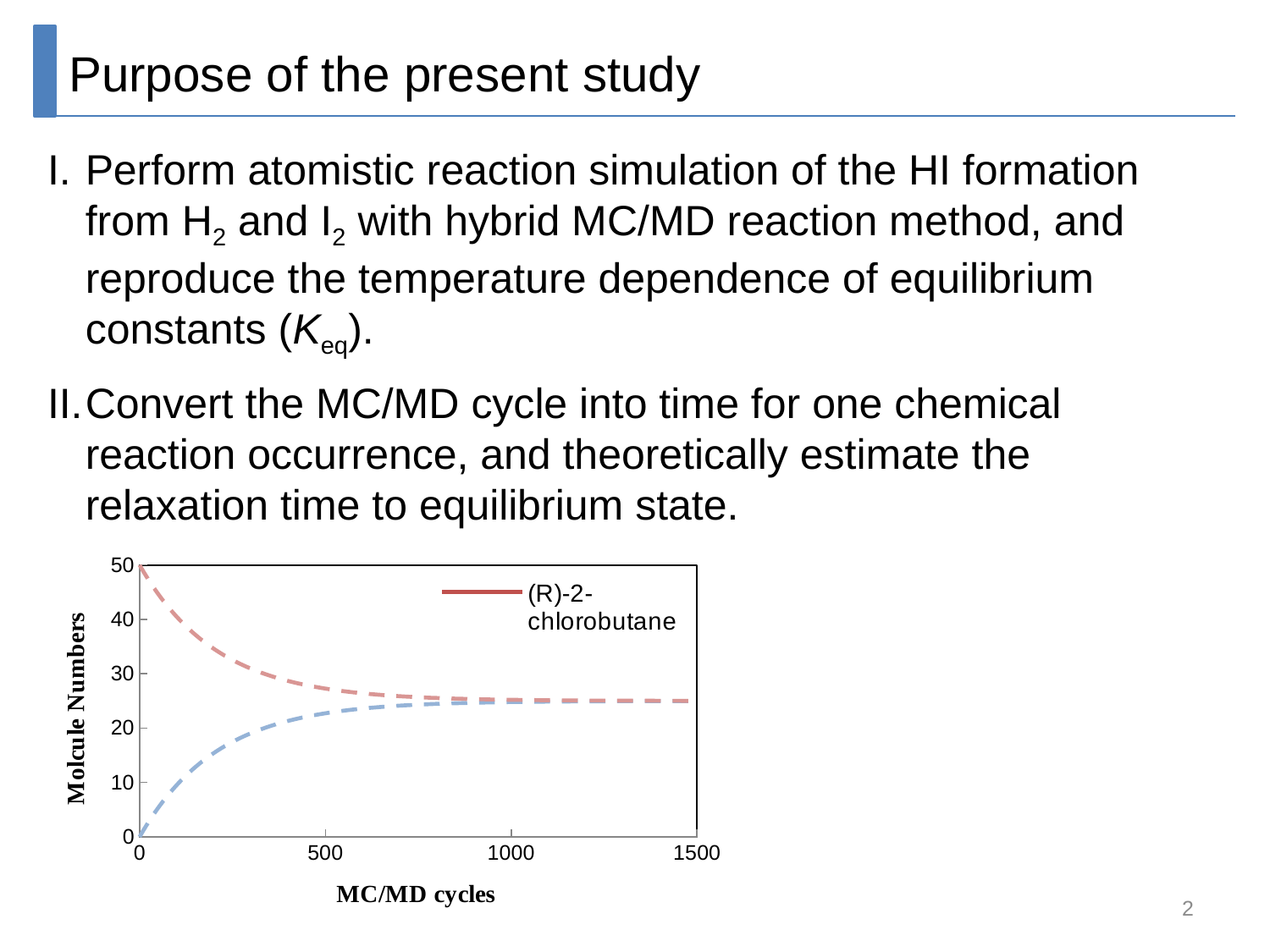
Is the value of (R)-2-chlorobutane at 1500 MC/MD cycles greater or less than 20? greater Does the (R)-2-chlorobutane line rise or fall as the MC/MD cycles increase? Fall What is the title of the x axis of the chart? MC/MD cycles Is the value of (R)-2-chlorobutane at 1500 MC/MD cycles greater or less than 30? less Is the value of (R)-2-chlorobutane at 500 MC/MD cycles greater or less than 40? less How many series does the chart legend list? 1 What is the highest value shown on the x axis of the chart? 1500 Which line is higher at 0 MC/MD cycles, the red dashed line or the blue dashed line? The red dashed line What type of chart is shown on the slide? Line chart What series name appears in the chart legend? (R)-2-chlorobutane